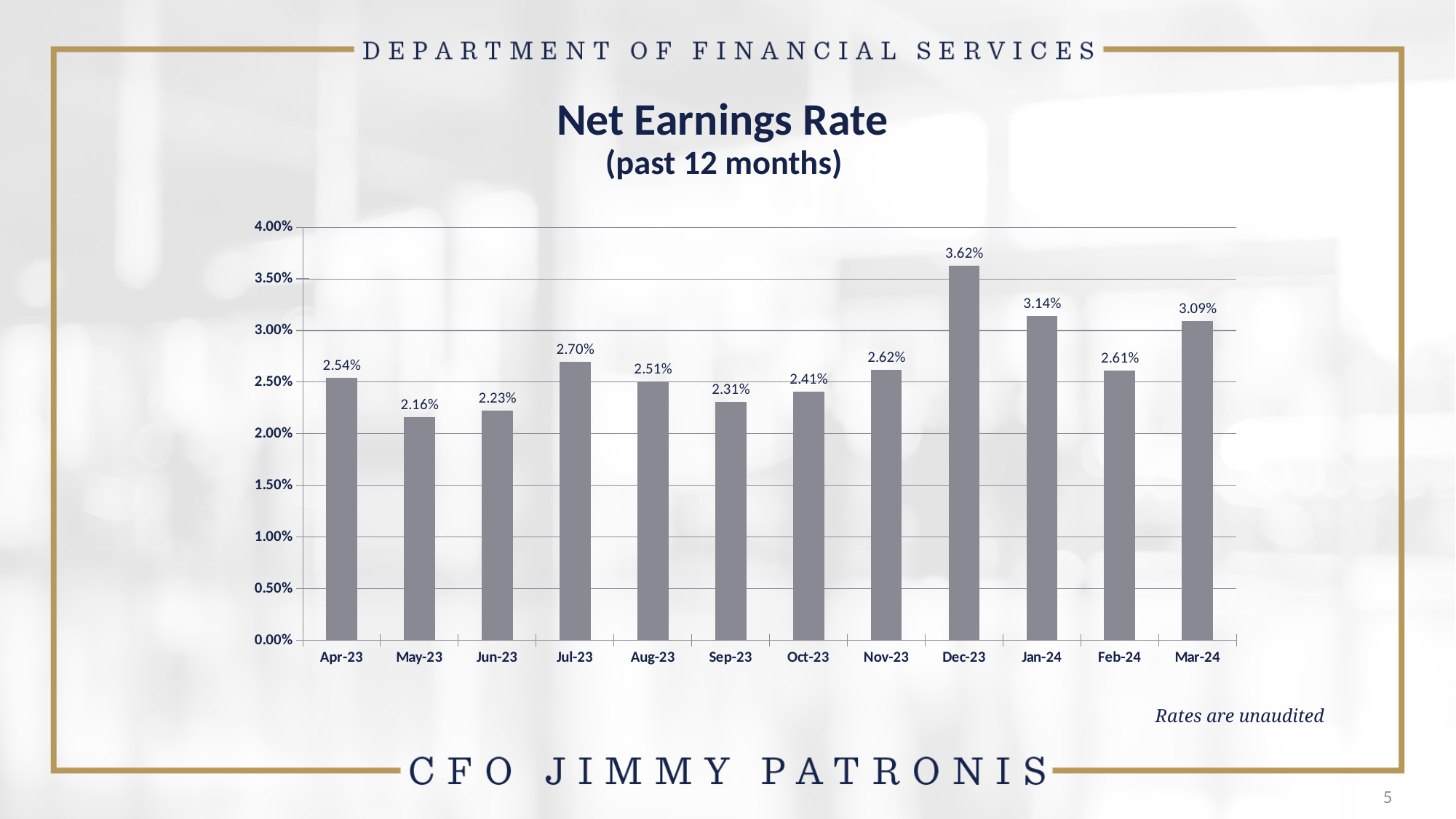
What is the net earnings rate for Oct-23? 2.41% What kind of chart is shown on the slide? Bar chart What is the net earnings rate for Dec-23? 3.62% What is the title of the chart? Net Earnings Rate (past 12 months) What is the net earnings rate for May-23? 2.16% Did the net earnings rate rise or fall from Apr-23 to May-23? Fall Which month has the highest net earnings rate? Dec-23 What is the difference between the net earnings rate in Jan-24 and Feb-24? 0.53% How many months are shown on the chart? 12 Is the net earnings rate for Mar-24 greater or less than 3.00%? greater Which month has a higher net earnings rate, Jul-23 or Nov-23? Jul-23 Which month has the lowest net earnings rate? May-23